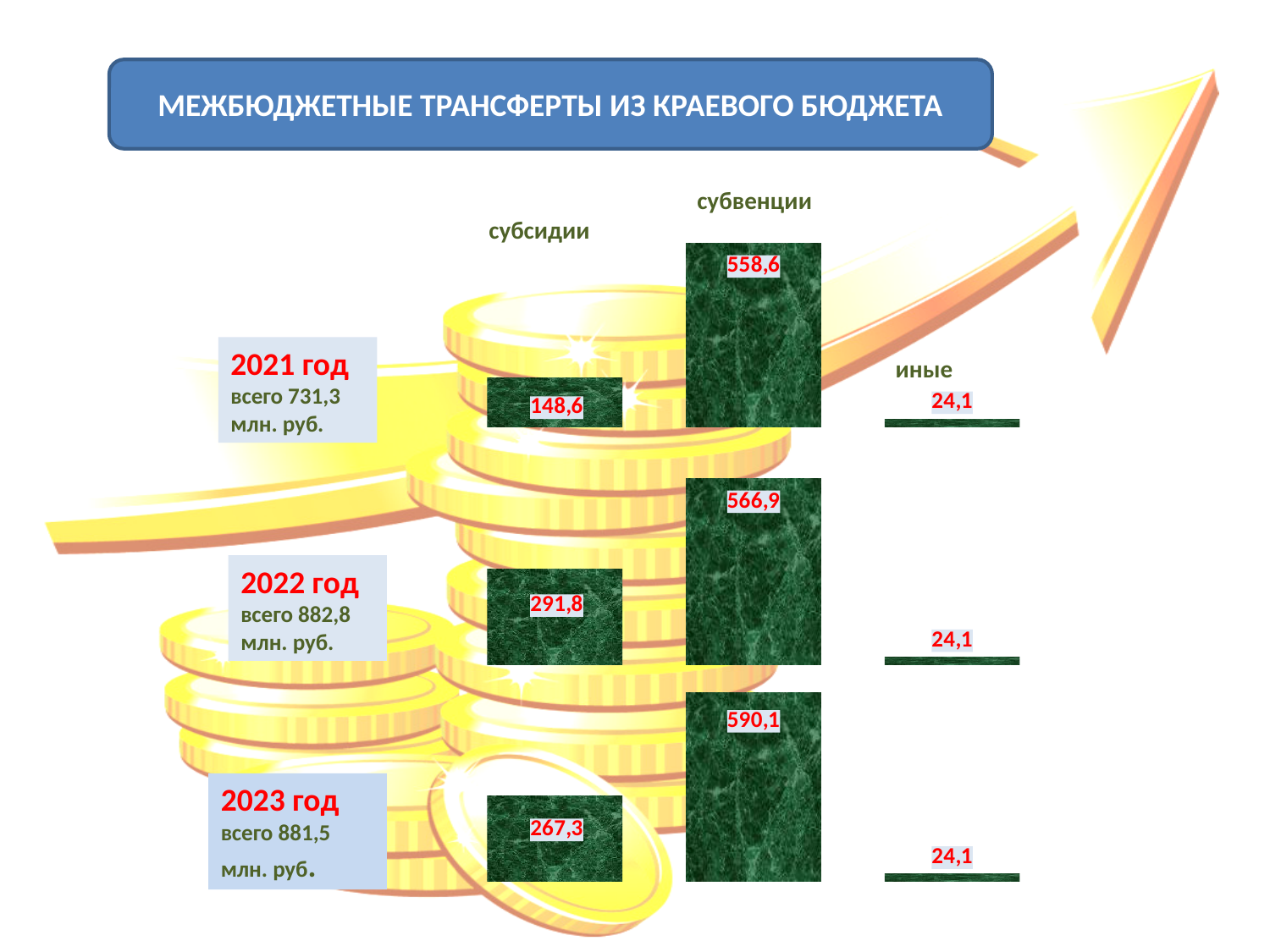
What is the value for иные in 2023 год? 24,1 In which year is the value for субвенции the highest? 2023 год What is the difference between субсидии in 2022 год and субсидии in 2021 год? 143,2 What is the total (всего) shown for 2022 год? 882,8 млн. руб. How many years are shown on the chart? 3 What is the value for субсидии in 2021 год? 148,6 What is the value for субвенции in 2022 год? 566,9 Which is larger: субсидии in 2022 год or субсидии in 2023 год? субсидии in 2022 год How many categories of transfers are shown for each year? 3 What is the title of the slide? МЕЖБЮДЖЕТНЫЕ ТРАНСФЕРТЫ ИЗ КРАЕВОГО БЮДЖЕТА In which year is the value for субсидии the lowest? 2021 год What is the value for субсидии in 2023 год? 267,3